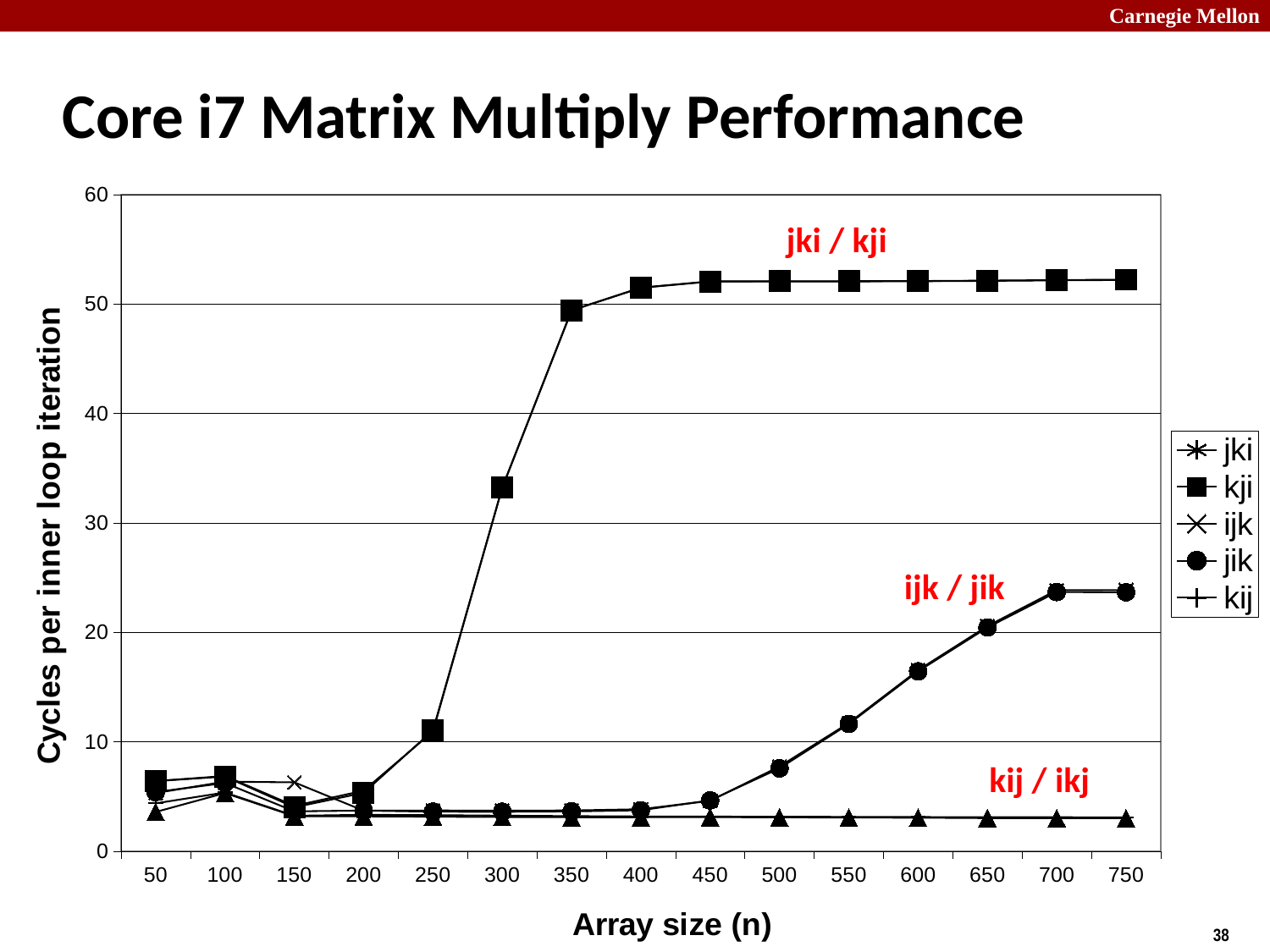
How many array sizes are marked along the x axis? 15 What is the label on the y axis? Cycles per inner loop iteration Is the value for jik at array size 700 greater or less than 20? greater Is the value for kji at array size 750 greater or less than 50? greater At array size 750, which is larger: the value for kji or the value for jik? kji Is the value for kji at array size 250 greater or less than 20? less What kind of chart is shown on the slide? line chart How many series does the legend list? 5 Does the kji series rise or fall between array sizes 200 and 400? rise